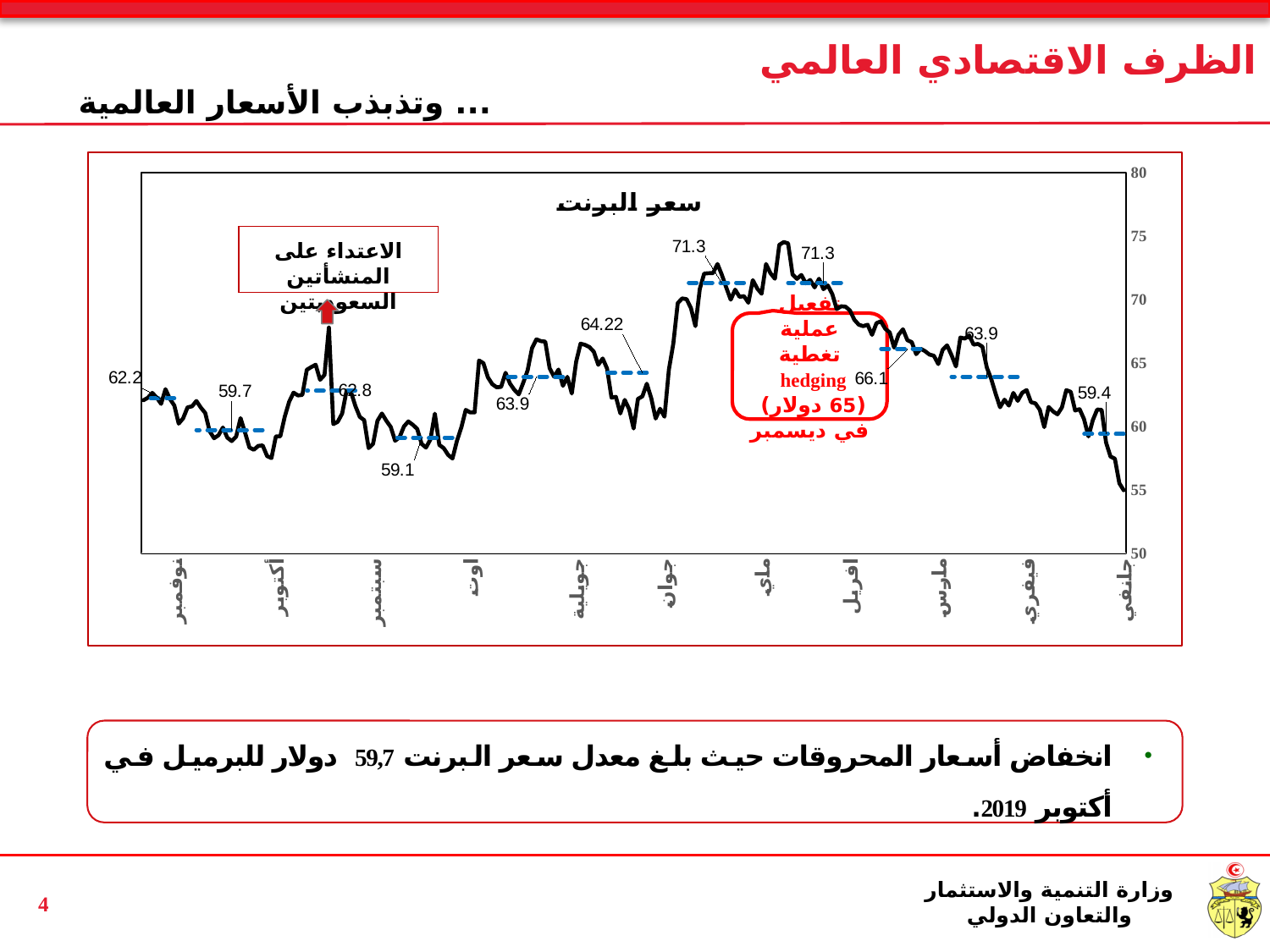
What is the labeled Brent price value for أكتوبر (October)? 59.7 What is the highest labeled Brent price value on the chart? 71.3 What is the labeled Brent price value for مارس (March)? 66.1 What is the labeled Brent price value for جوان (June)? 64.22 Which month has the lowest labeled Brent price value? اوت (August), 59.1 What is the labeled Brent price value for نوفمبر (November)? 62.2 What is the title of the chart? سعر البرنت Which has a higher labeled value, سبتمبر (September) or اوت (August)? سبتمبر (September) How many months are labeled on the x axis? 11 What is the labeled Brent price value for جانفي (January)? 59.4 What type of chart is shown on the slide? line chart What is the difference between the labeled values for ماي (May) and أكتوبر (October)? 11.6